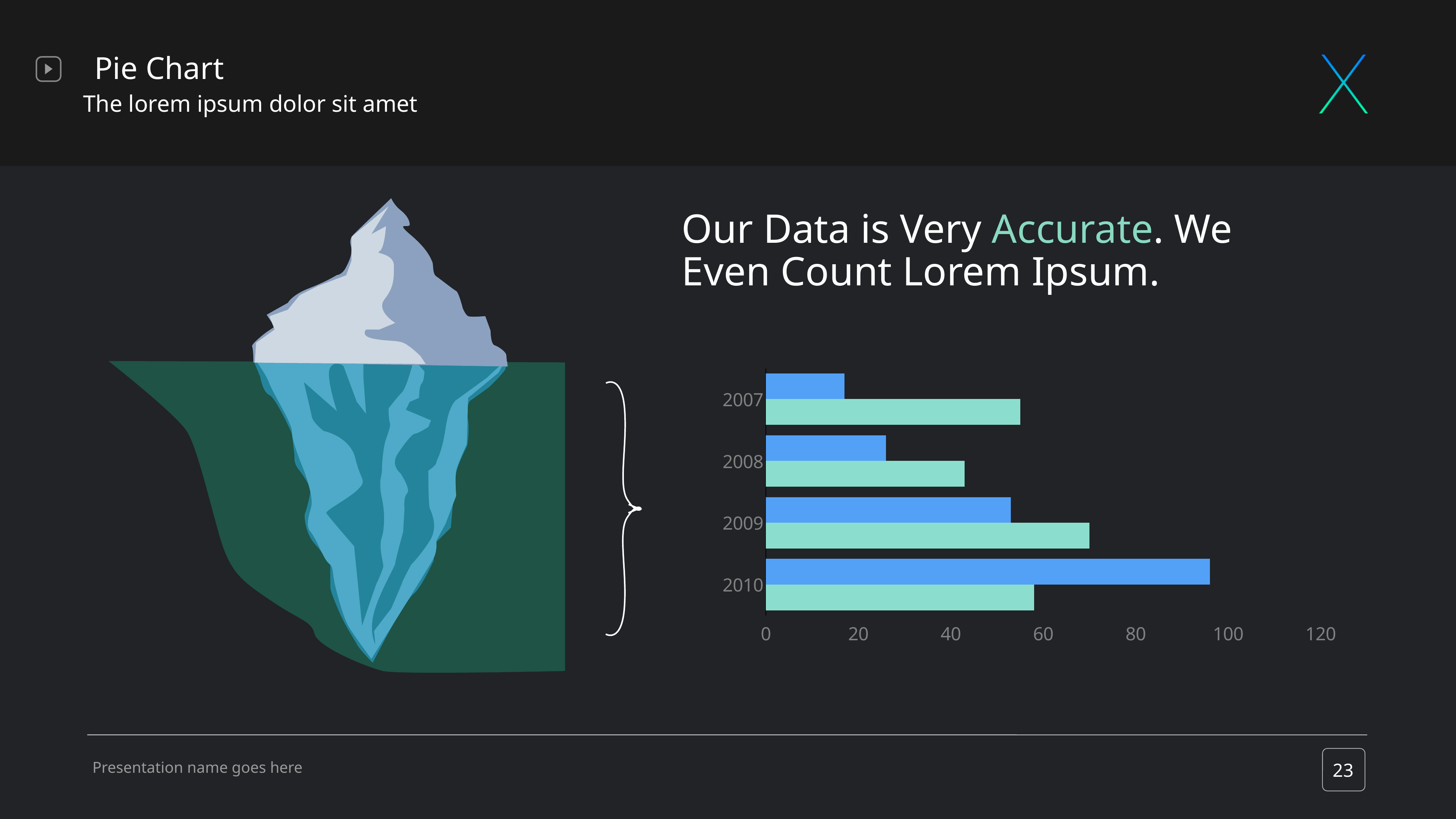
Which year has the longest blue bar? 2010 Do the blue bars get longer or shorter from 2007 to 2010? longer For 2007, which bar is longer, the blue one or the green one? green Is the green bar for 2009 greater or less than 60? greater Is the blue bar for 2007 greater or less than 20? less Is the blue bar for 2010 greater or less than 80? greater Which year has the longest green bar? 2009 Which year has the shortest blue bar? 2007 What kind of chart is shown on the slide? bar chart For 2010, which bar is longer, the blue one or the green one? blue How many categories (years) are shown on the chart's vertical axis? 4 Which year has the shortest green bar? 2008